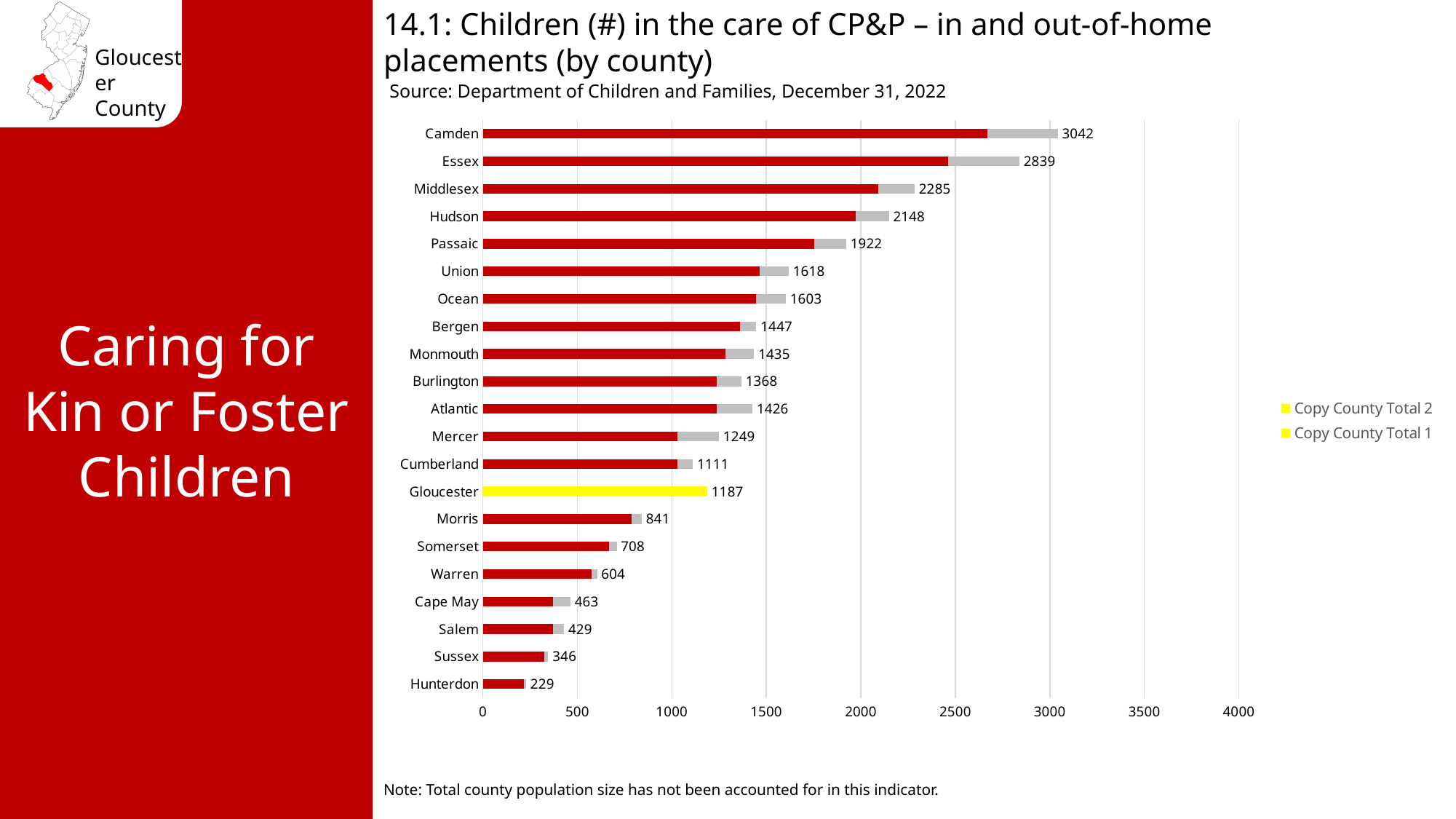
What kind of chart is shown on the slide? Bar chart How many counties are shown in the chart? 21 How many series does the legend list? 2 Which county has the highest total in the chart? Camden What value is labelled for Passaic? 1922 What value is labelled for Gloucester? 1187 What is the difference between the totals for Gloucester and Cumberland? 76 What is the difference between the totals for Camden and Essex? 203 Which has a larger total, Atlantic or Burlington? Atlantic What is the total number of children in the care of CP&P shown for Camden? 3042 Which county has the lowest total in the chart? Hunterdon What value is shown for Hunterdon? 229